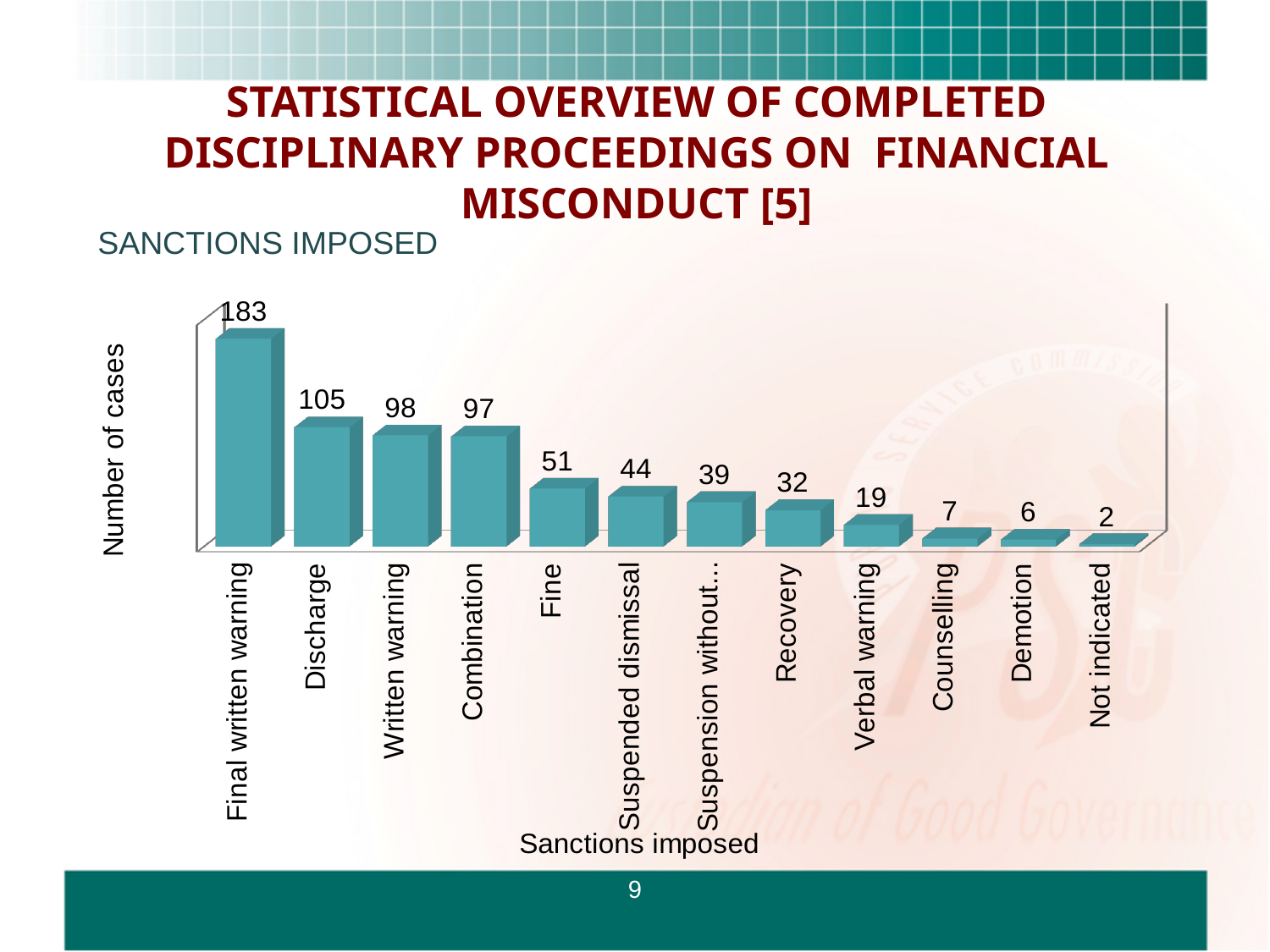
Which has more cases, Counselling or Verbal warning? Verbal warning What is the difference in number of cases between Discharge and Written warning? 7 Which sanction has the lowest number of cases? Not indicated What is the number of cases for Discharge? 105 What type of chart is shown on the slide? Bar chart Which sanction has the highest number of cases? Final written warning What is the number of cases for Recovery? 32 What is the label of the vertical axis? Number of cases How many cases received a final written warning? 183 Which has more cases, Fine or Suspended dismissal? Fine How many sanction categories are shown on the x axis? 12 What is the difference in number of cases between Final written warning and Combination? 86